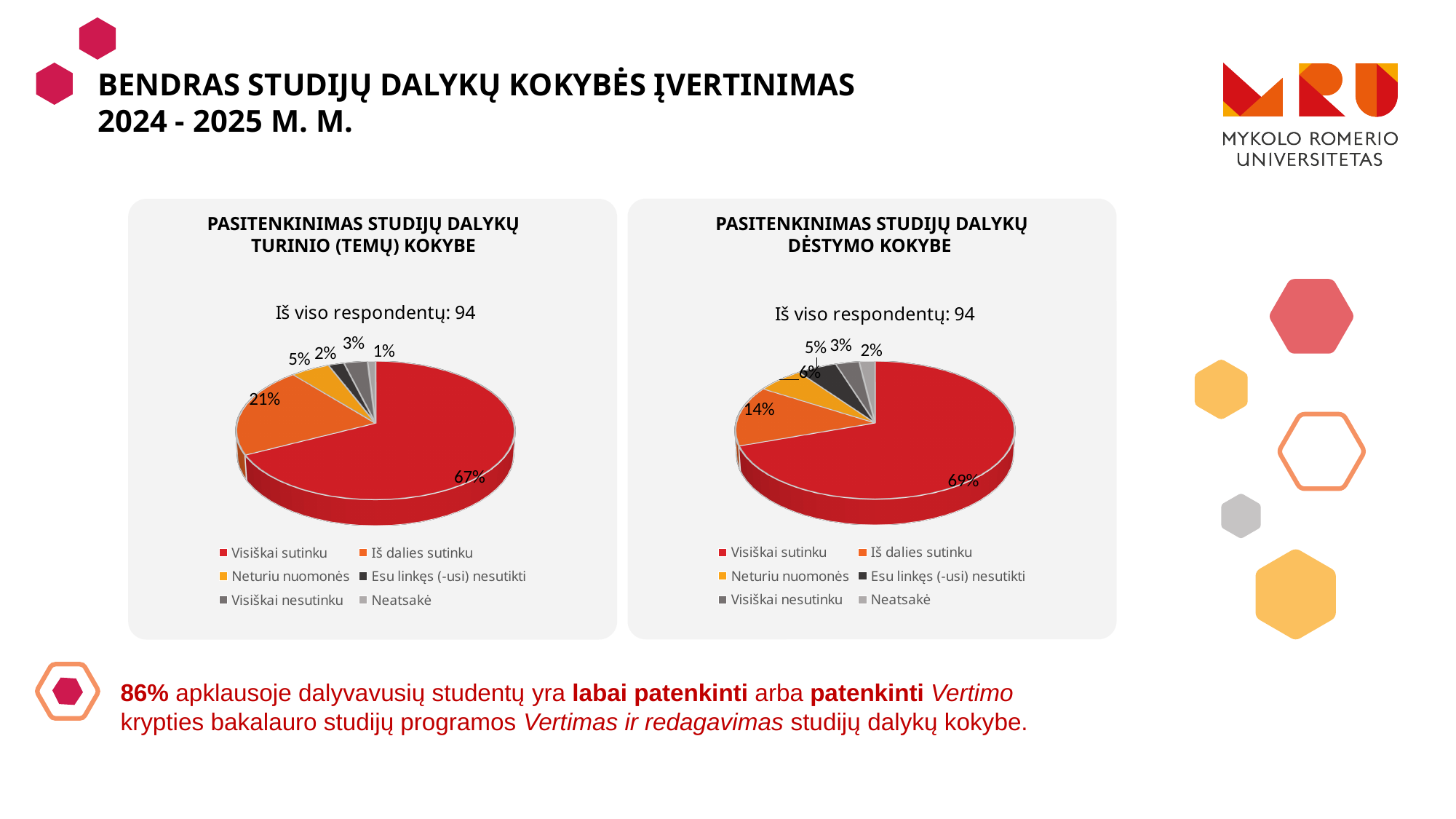
How many categories does the legend of the right chart, 'Pasitenkinimas studijų dalykų dėstymo kokybe', list? 6 In the left chart, 'Pasitenkinimas studijų dalykų turinio (temų) kokybe', what share is 'Iš dalies sutinku'? 21% In the right chart, 'Pasitenkinimas studijų dalykų dėstymo kokybe', which category has the largest share? Visiškai sutinku What type of chart is used on the left chart, 'Pasitenkinimas studijų dalykų turinio (temų) kokybe'? Pie chart Which chart has the larger 'Iš dalies sutinku' share, the left chart (turinio kokybe) or the right chart (dėstymo kokybe)? The left chart (turinio kokybe) How many respondents does the left chart, 'Pasitenkinimas studijų dalykų turinio (temų) kokybe', report in total? 94 In the left chart, 'Pasitenkinimas studijų dalykų turinio (temų) kokybe', what share is 'Visiškai sutinku'? 67% In the left chart, 'Pasitenkinimas studijų dalykų turinio (temų) kokybe', what is the difference between the 'Visiškai sutinku' and 'Iš dalies sutinku' shares? 46% In the left chart, 'Pasitenkinimas studijų dalykų turinio (temų) kokybe', which category has the smallest share? Neatsakė In the right chart, 'Pasitenkinimas studijų dalykų dėstymo kokybe', what share is 'Neturiu nuomonės'? 6%